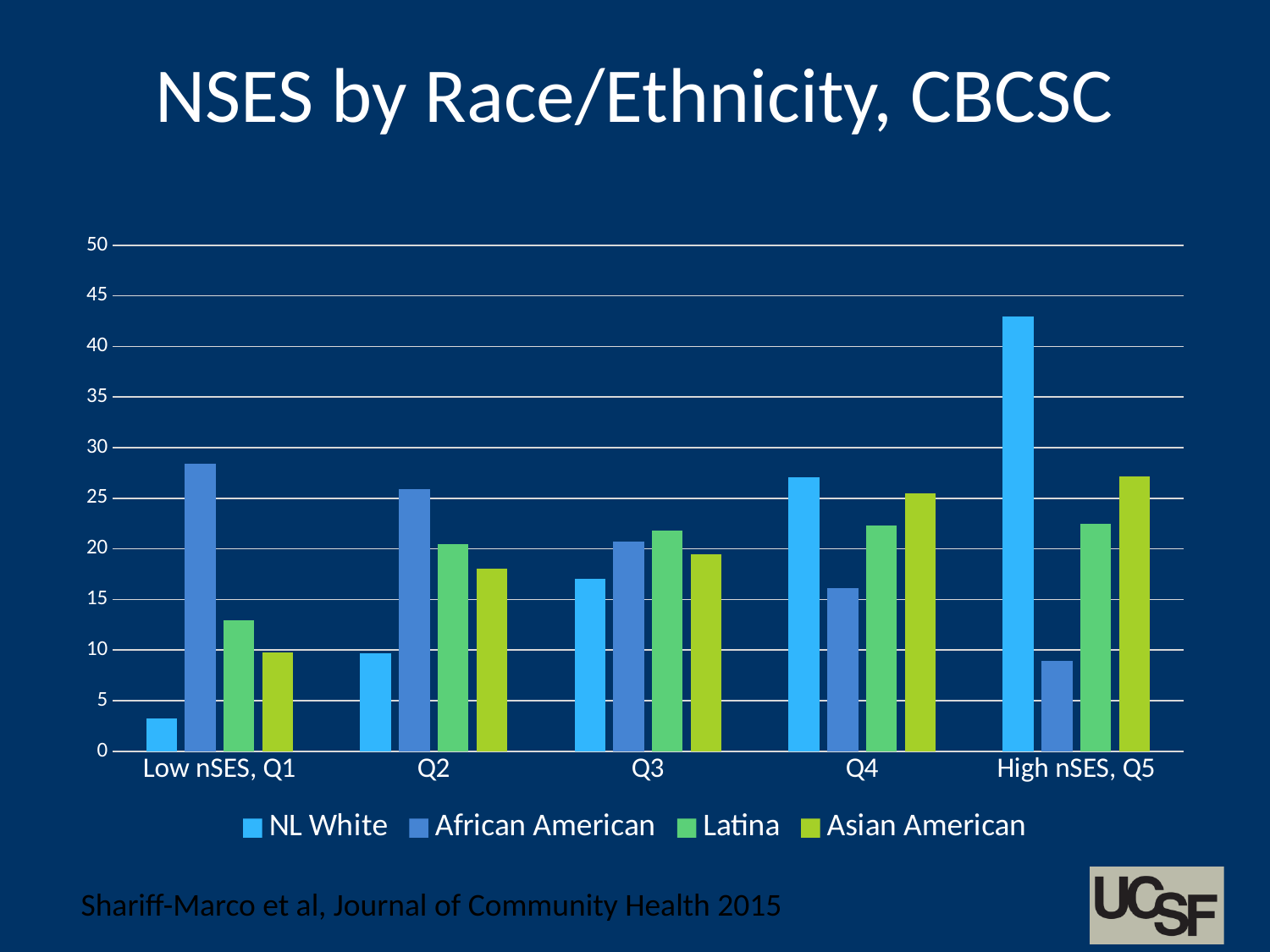
Do the NL White values rise or fall from Low nSES, Q1 to High nSES, Q5? rise In which nSES category is the NL White value highest? High nSES, Q5 At Q4, which is larger: the NL White value or the African American value? NL White What is the title of the chart? NSES by Race/Ethnicity, CBCSC Is the NL White value for High nSES, Q5 greater or less than 40? greater How many series does the legend list? 4 What kind of chart is shown on the slide? bar chart In which nSES category is the NL White value lowest? Low nSES, Q1 How many nSES categories are shown on the x axis? 5 In which nSES category is the African American value lowest? High nSES, Q5 Is the African American value for Low nSES, Q1 greater or less than 25? greater In which nSES category is the African American value highest? Low nSES, Q1